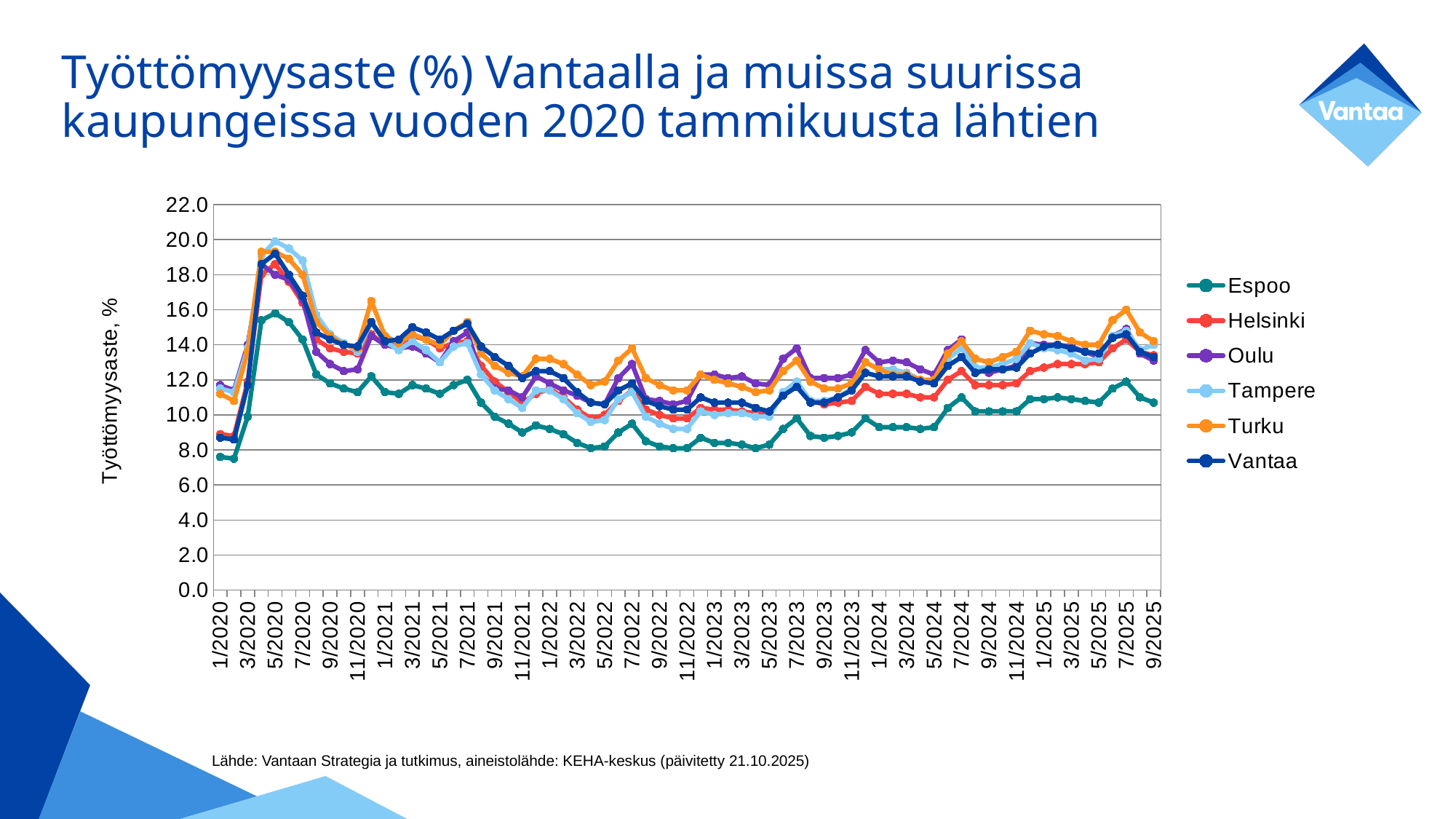
Which city has the highest unemployment rate at 7/2025? Turku Which city has the lowest unemployment rate at 9/2025? Espoo What is the label on the vertical axis of the chart? Työttömyysaste, % Is the value for Espoo at 1/2020 greater or less than 10.0? less What kind of chart is shown on the slide? line chart Is the value for Turku at 7/2025 greater or less than 14.0? greater Does the value for Espoo rise or fall between 5/2020 and 9/2020? fall How many series does the legend list? 6 Which city has the lowest unemployment rate at 5/2020? Espoo At 9/2025, which is larger, the value for Turku or the value for Espoo? Turku Is the value for Espoo at 9/2022 greater or less than 10.0? less